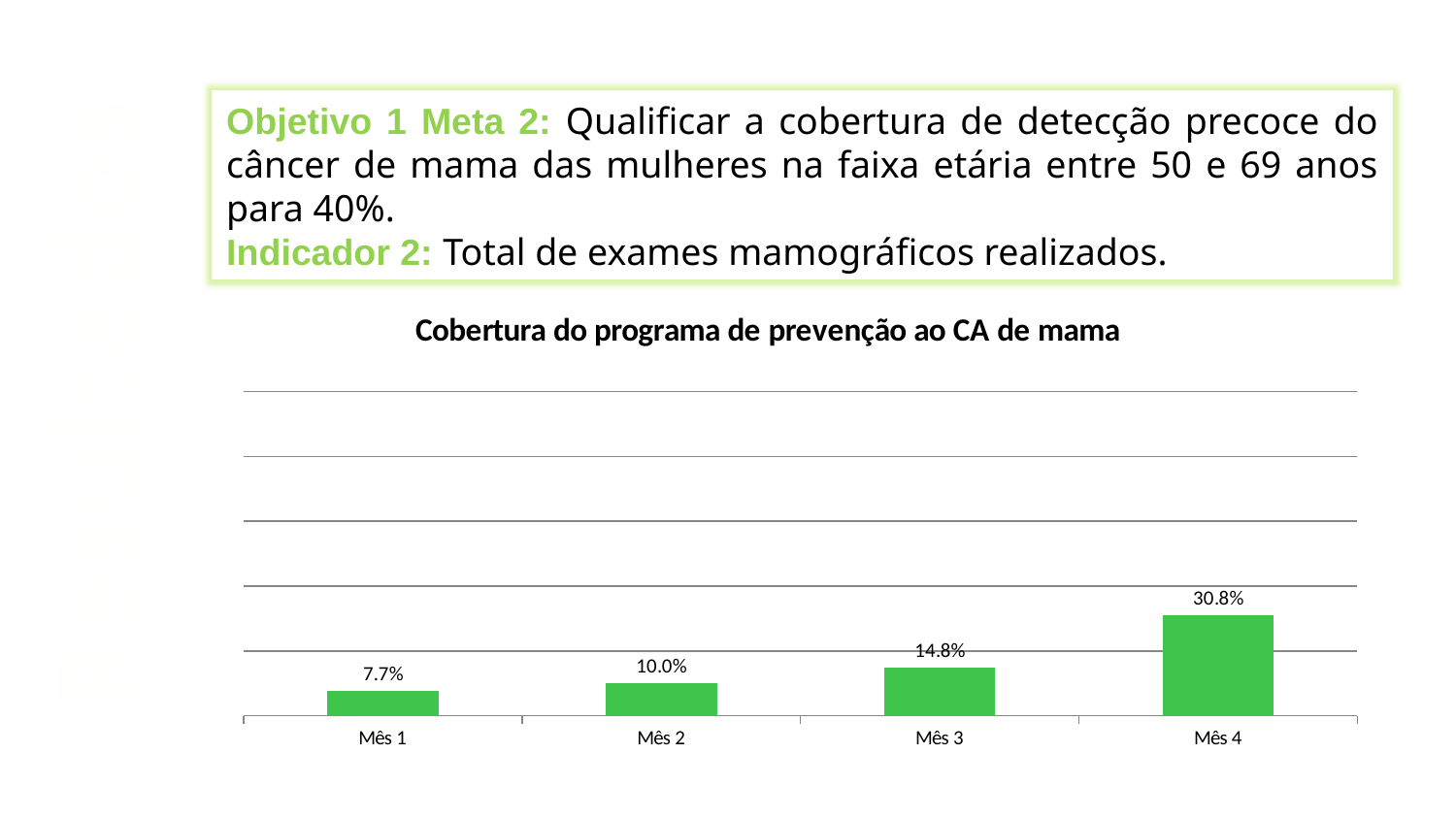
What is the difference between the values for Mês 2 and Mês 1? 2.3% Which month has the lowest value? Mês 1 Which is larger, the value for Mês 2 or the value for Mês 3? Mês 3 What is the value for Mês 3? 14.8% What is the difference between the values for Mês 4 and Mês 3? 16.0% What is the value for Mês 1? 7.7% What is the value for Mês 2? 10.0% What kind of chart is shown? Bar chart How many months are shown on the chart? 4 Do the values rise or fall from Mês 1 to Mês 4? Rise Which month has the highest value? Mês 4 What is the value for Mês 4? 30.8%